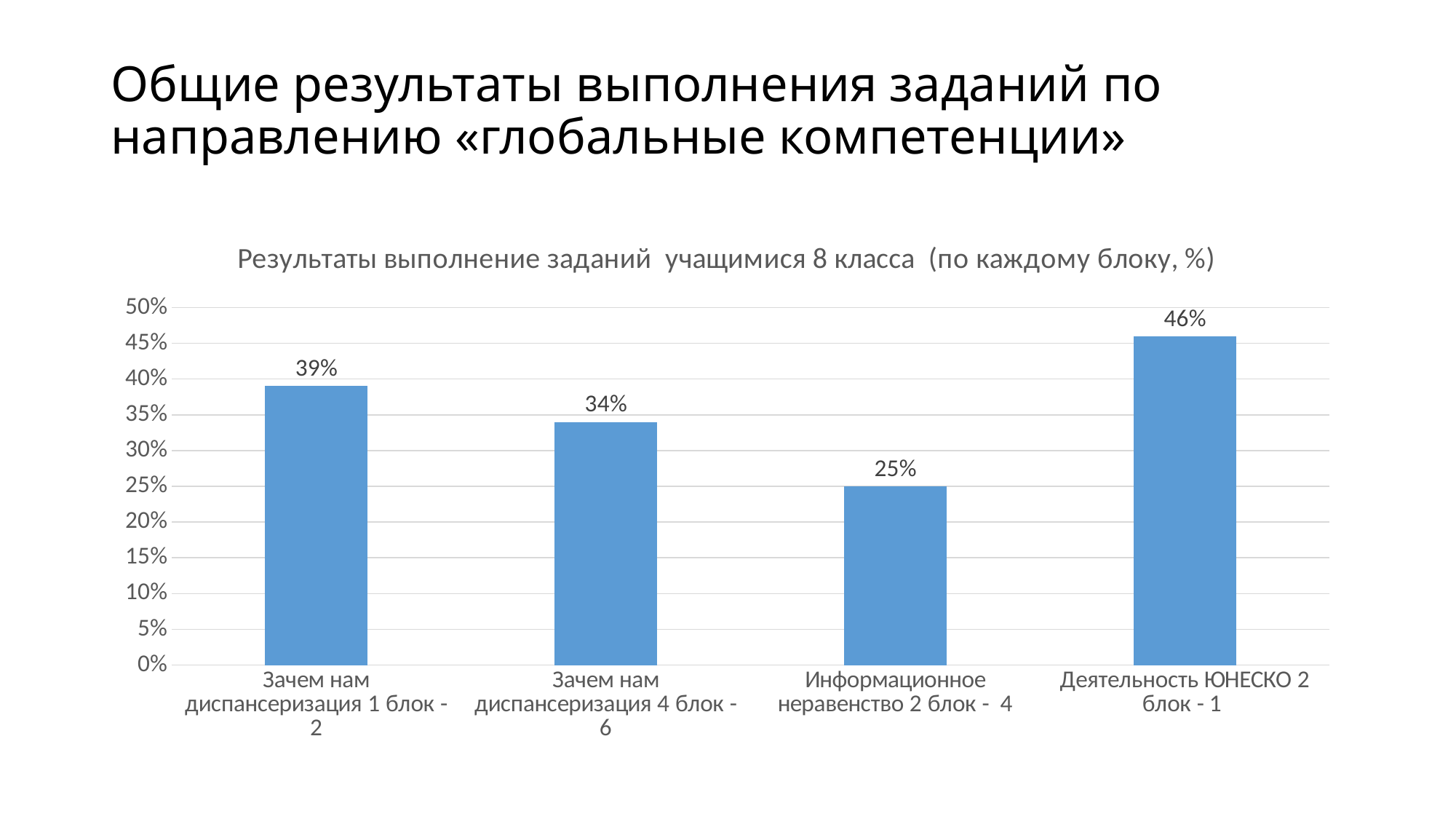
What is the value for «Зачем нам диспансеризация 4 блок - 6»? 34% What is the value for «Деятельность ЮНЕСКО 2 блок - 1»? 46% What kind of chart is shown on the slide? bar chart Which category has the highest value? Деятельность ЮНЕСКО 2 блок - 1 What is the title of the chart? Результаты выполнение заданий учащимися 8 класса (по каждому блоку, %) How many categories are shown in the chart? 4 What is the difference between the values for «Деятельность ЮНЕСКО 2 блок - 1» and «Информационное неравенство 2 блок - 4»? 21% What is the value for «Информационное неравенство 2 блок - 4»? 25% Which is larger: the value for «Зачем нам диспансеризация 1 блок - 2» or «Зачем нам диспансеризация 4 блок - 6»? Зачем нам диспансеризация 1 блок - 2 What is the value for «Зачем нам диспансеризация 1 блок - 2»? 39% Is the value for «Деятельность ЮНЕСКО 2 блок - 1» greater or less than 40%? greater Which category has the lowest value? Информационное неравенство 2 блок - 4